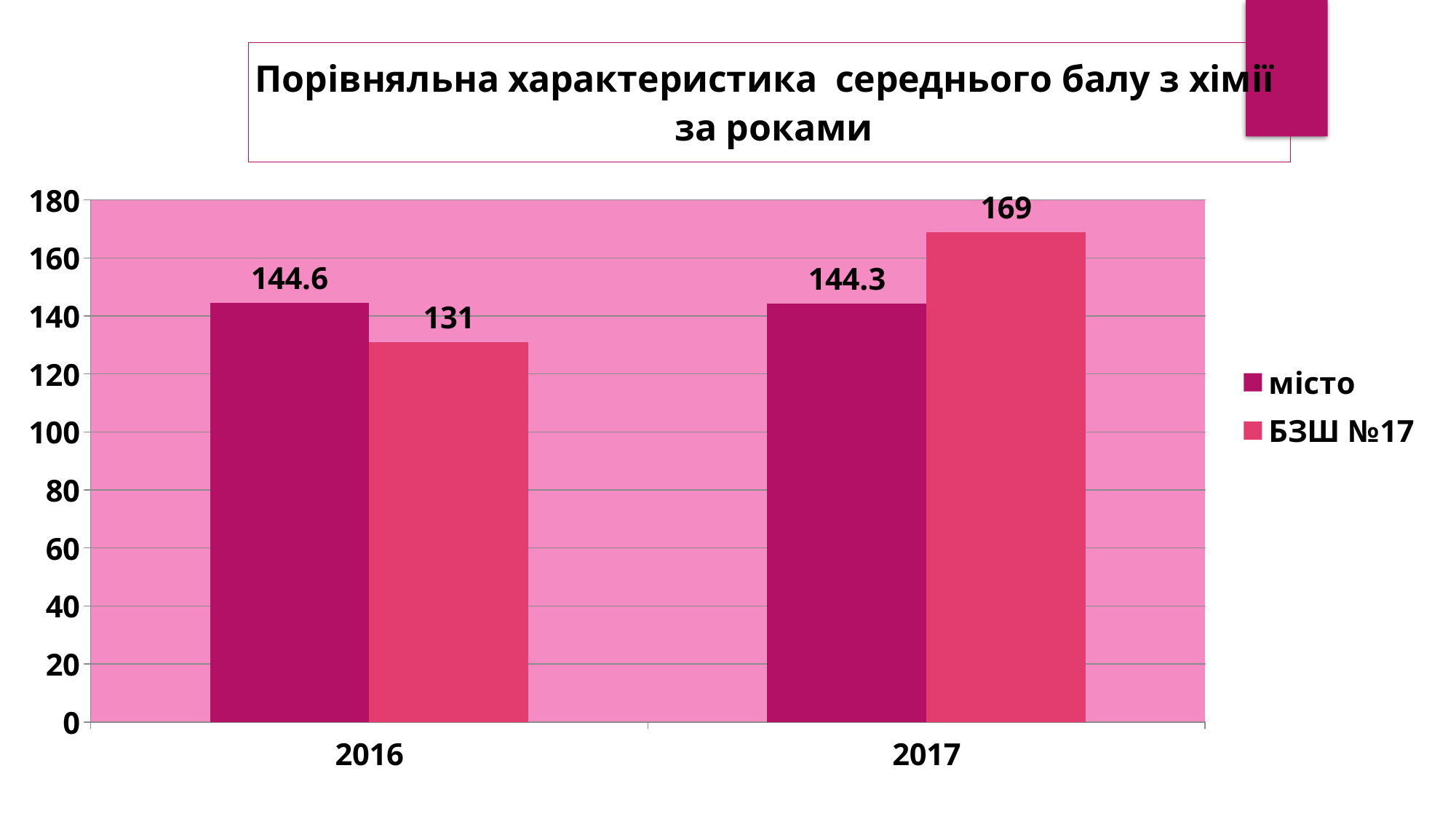
What is the difference between місто and БЗШ №17 in 2016? 13.6 How many series does the legend list? 2 What is the value for БЗШ №17 in 2016? 131 Which is larger in 2016, місто or БЗШ №17? місто What is the value for місто in 2017? 144.3 What kind of chart is shown on the slide? bar chart Do the values for БЗШ №17 rise or fall from 2016 to 2017? rise Which bar has the lowest value on the chart? БЗШ №17 in 2016 What is the difference between БЗШ №17 and місто in 2017? 24.7 What is the value for місто in 2016? 144.6 What is the value for БЗШ №17 in 2017? 169 Which year has the highest value for БЗШ №17? 2017